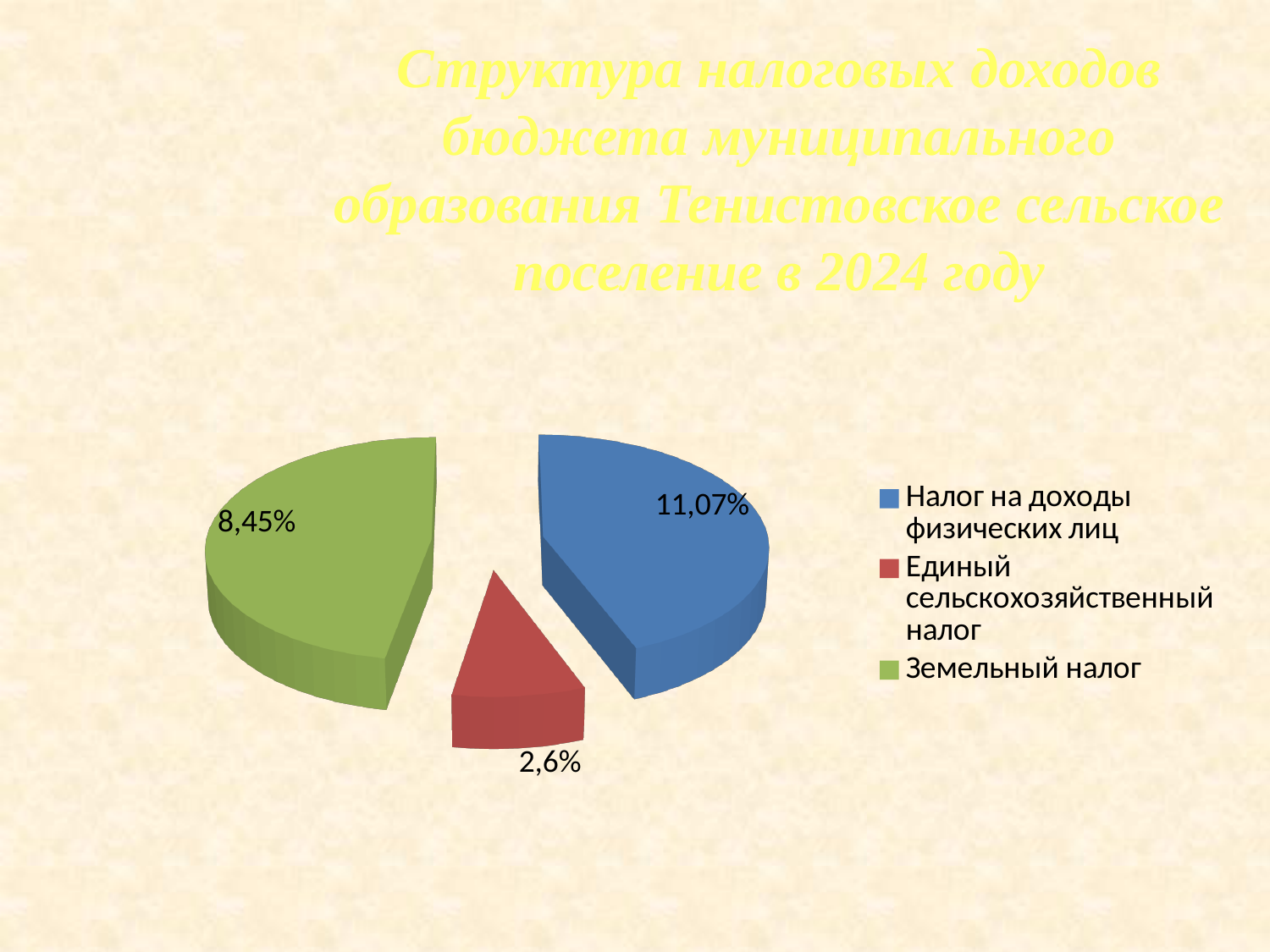
What colour is the slice for "Земельный налог"? Green What value is labelled on the slice for "Земельный налог"? 8,45% Which category has the smallest slice in the pie chart? Единый сельскохозяйственный налог Which is larger: the value for "Земельный налог" or the value for "Единый сельскохозяйственный налог"? Земельный налог Which category has the largest slice in the pie chart? Земельный налог How many slices does the pie chart have? 3 What is the difference between the labelled values for "Земельный налог" and "Единый сельскохозяйственный налог"? 5,85% What is the difference between the labelled values for "Налог на доходы физических лиц" and "Земельный налог"? 2,62% How many entries does the legend list? 3 What value is labelled on the slice for "Единый сельскохозяйственный налог"? 2,6% What value is labelled on the slice for "Налог на доходы физических лиц"? 11,07% What type of chart is shown on the slide? Pie chart